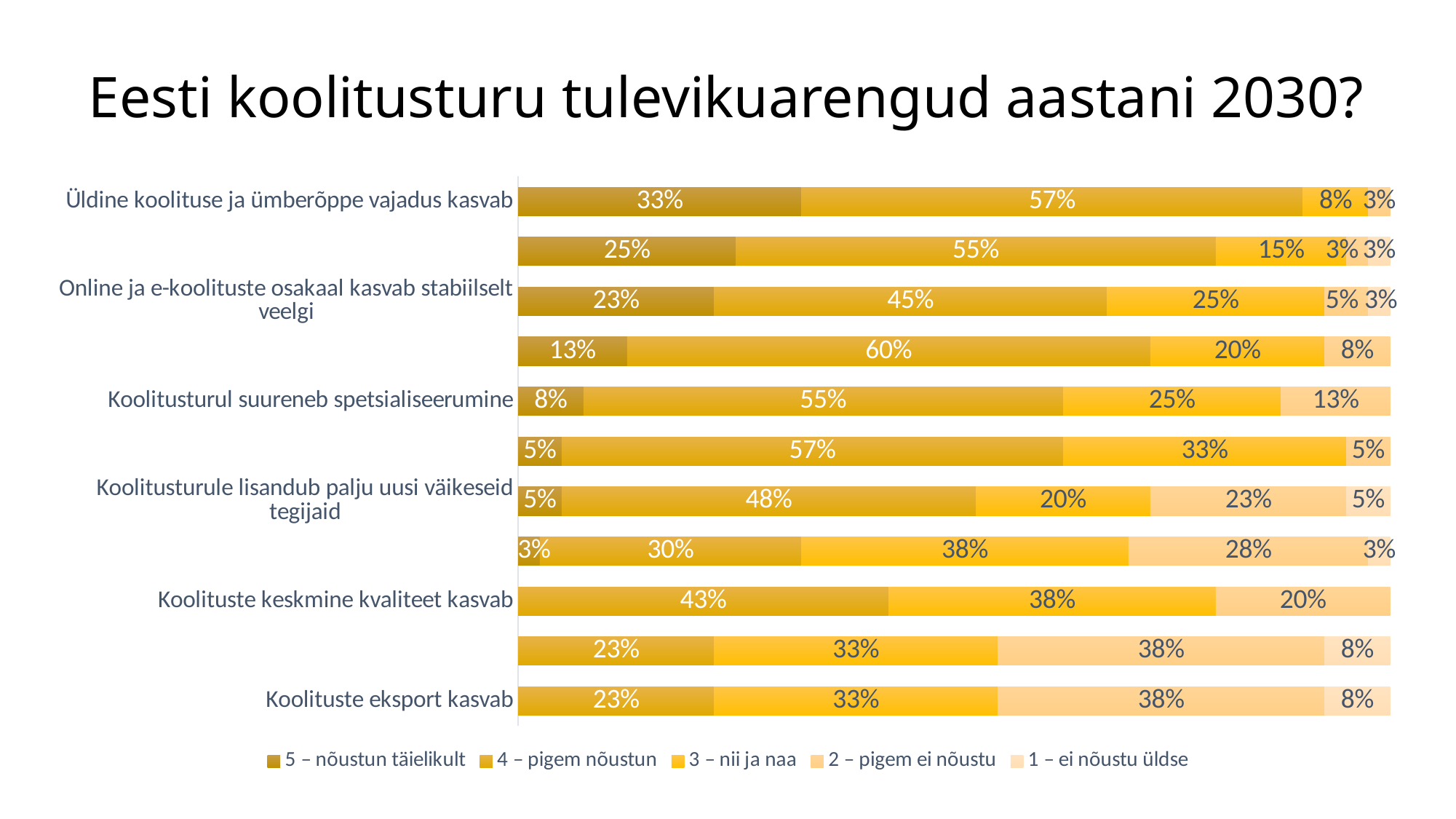
What is the title of the slide? Eesti koolitusturu tulevikuarengud aastani 2030? How many series does the legend list? 5 What is the value of "4 – pigem nõustun" for "Koolitusturul suureneb spetsialiseerumine"? 55% Which has a larger "5 – nõustun täielikult" share: "Üldine koolituse ja ümberõppe vajadus kasvab" or "Online ja e-koolituste osakaal kasvab stabiilselt veelgi"? Üldine koolituse ja ümberõppe vajadus kasvab Which has a larger "3 – nii ja naa" share: "Koolitusturul suureneb spetsialiseerumine" or "Koolituste eksport kasvab"? Koolituste eksport kasvab What is the difference in the "4 – pigem nõustun" share between "Üldine koolituse ja ümberõppe vajadus kasvab" and "Online ja e-koolituste osakaal kasvab stabiilselt veelgi"? 12 percentage points What is the value of "5 – nõustun täielikult" for "Üldine koolituse ja ümberõppe vajadus kasvab"? 33% What is the value of "2 – pigem ei nõustu" for "Koolituste eksport kasvab"? 38% What type of chart is shown on the slide? Stacked bar chart What is the value of "3 – nii ja naa" for "Koolituste keskmine kvaliteet kasvab"? 38% How many bars are plotted in the chart? 11 What is the value of "2 – pigem ei nõustu" for "Koolitusturule lisandub palju uusi väikeseid tegijaid"? 23%